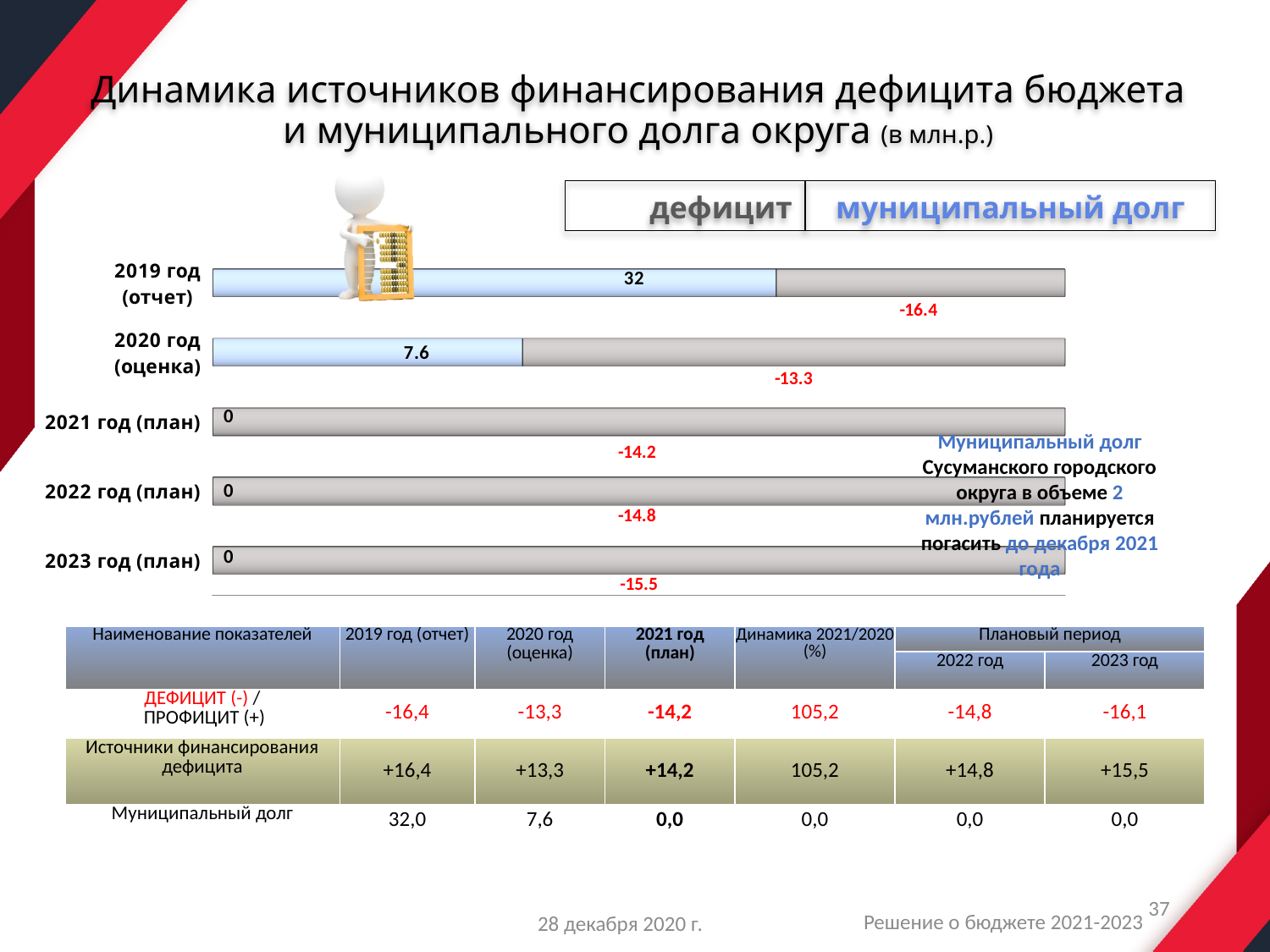
Which series is shown in blue in the legend? муниципальный долг What type of chart is shown on the slide? bar chart Does the муниципальный долг value rise or fall from 2019 to 2023? fall How many year categories does the chart show? 5 Which year has the highest value of муниципальный долг? 2019 год (отчет) What is the value of муниципальный долг for 2020 год (оценка)? 7.6 How many series does the chart legend list? 2 What is the value of муниципальный долг for 2019 год (отчет)? 32 What is the value of дефицит for 2019 год (отчет)? -16.4 What is the value of дефицит for 2021 год (план)? -14.2 What is the value of дефицит for 2023 год (план)? -15.5 What is the difference between the муниципальный долг values for 2019 год (отчет) and 2020 год (оценка)? 24.4